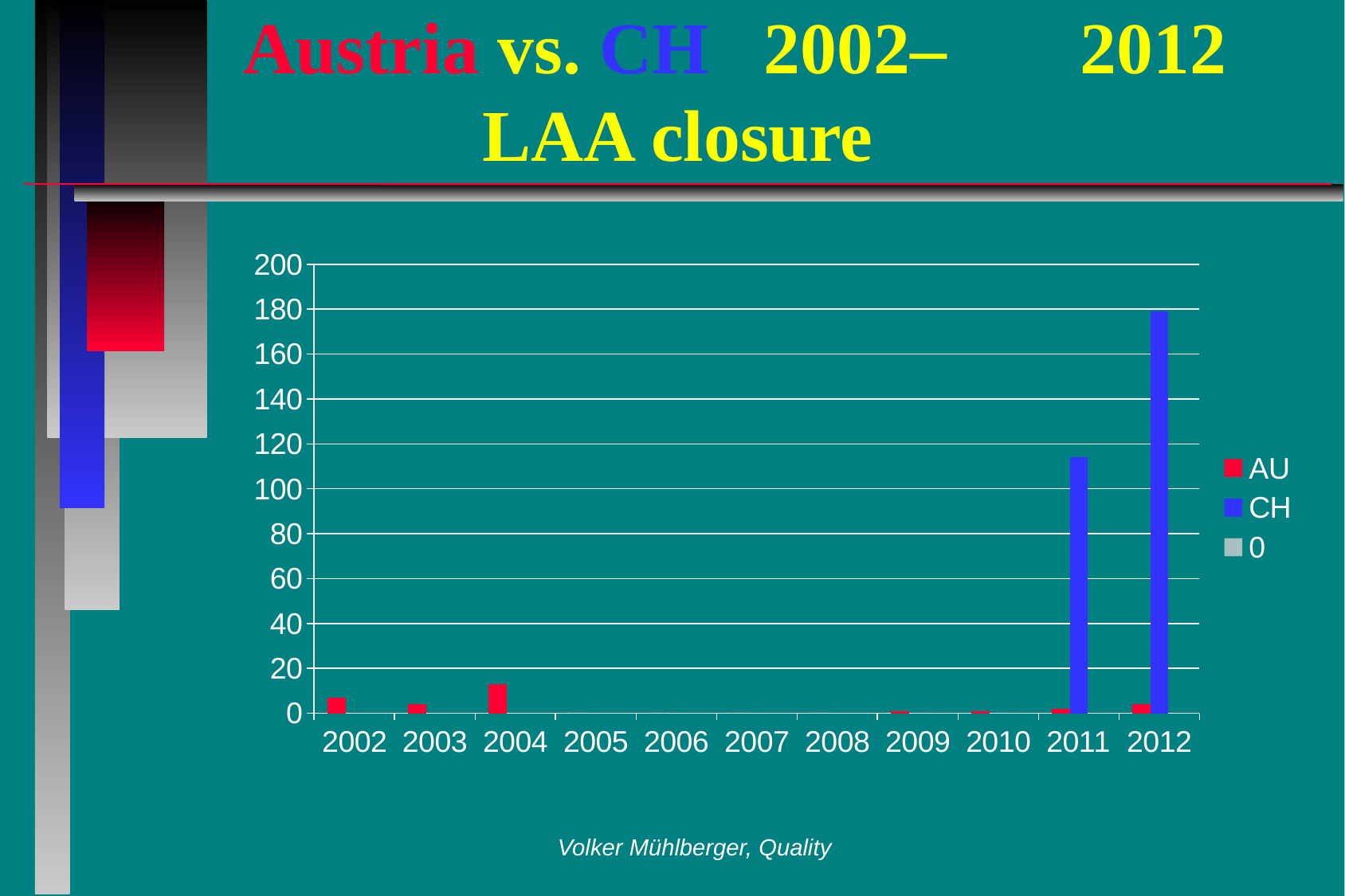
How many years are shown along the x axis of the chart? 11 Which is larger in 2012, the AU value or the CH value? CH Which year has the highest CH value? 2012 Is the AU value for 2004 greater or less than 20? less Is the CH value for 2011 greater or less than 100? greater How many series does the chart's legend list? 3 Is the CH value for 2012 greater or less than 160? greater What colour are the CH bars in the chart? blue Which is larger, the CH value for 2011 or the CH value for 2012? 2012 Which year has the highest AU value? 2004 What kind of chart is shown on the slide? bar chart